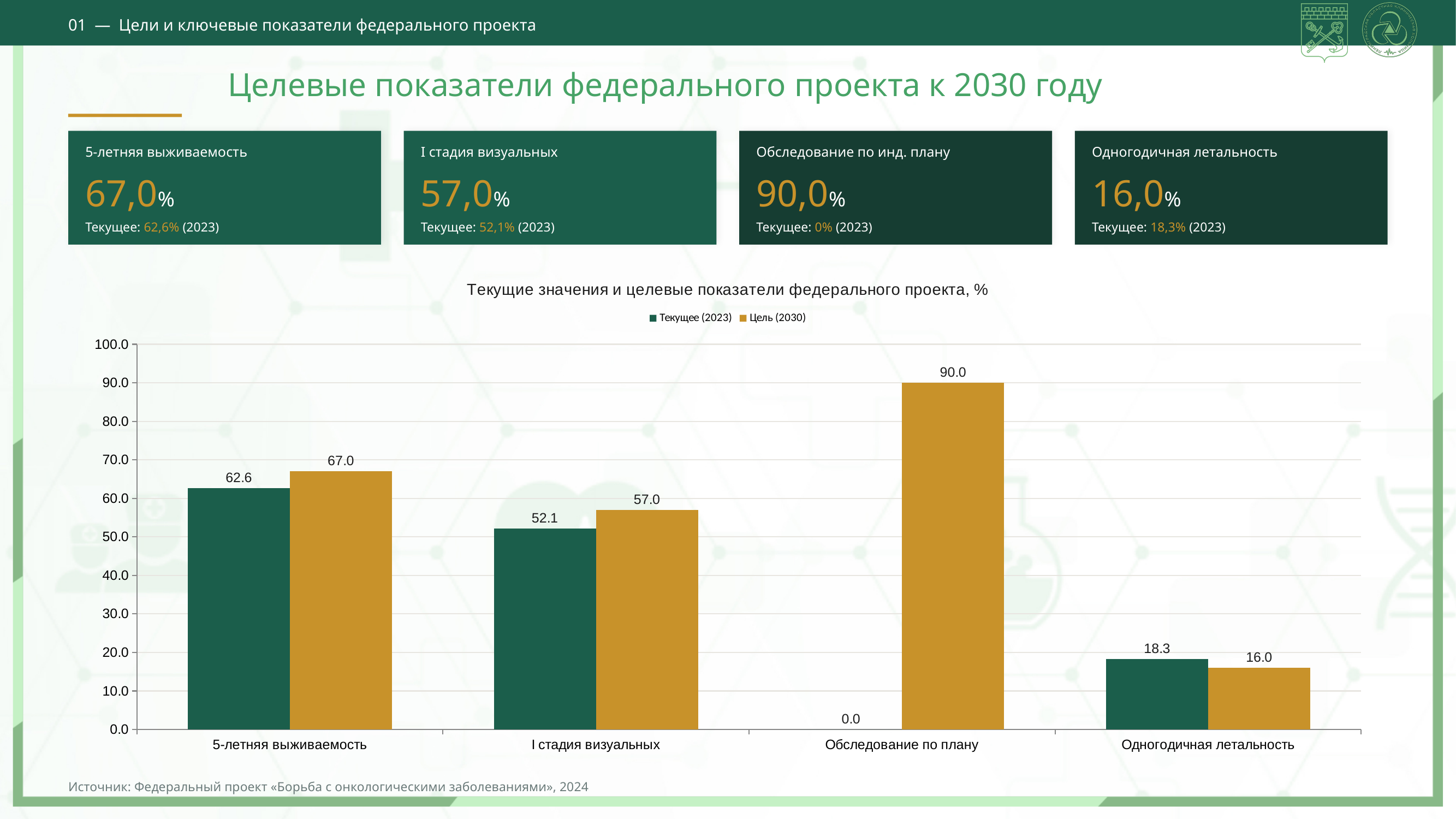
What is the Текущее (2023) value for 5-летняя выживаемость? 62.6 What is the title of the chart? Текущие значения и целевые показатели федерального проекта, % For Одногодичная летальность, which is larger: the Текущее (2023) value or the Цель (2030) value? Текущее (2023) Is the Цель (2030) value for 5-летняя выживаемость greater or less than 60.0? greater What kind of chart is shown on the slide? bar chart How many series does the chart legend list? 2 Which category has the highest Цель (2030) value? Обследование по плану How many categories are shown on the x axis of the chart? 4 What is the Текущее (2023) value for Одногодичная летальность? 18.3 What is the difference between the Цель (2030) and Текущее (2023) values for I стадия визуальных? 4.9 What is the Цель (2030) value for Обследование по плану? 90.0 Which category has the lowest Текущее (2023) value? Обследование по плану